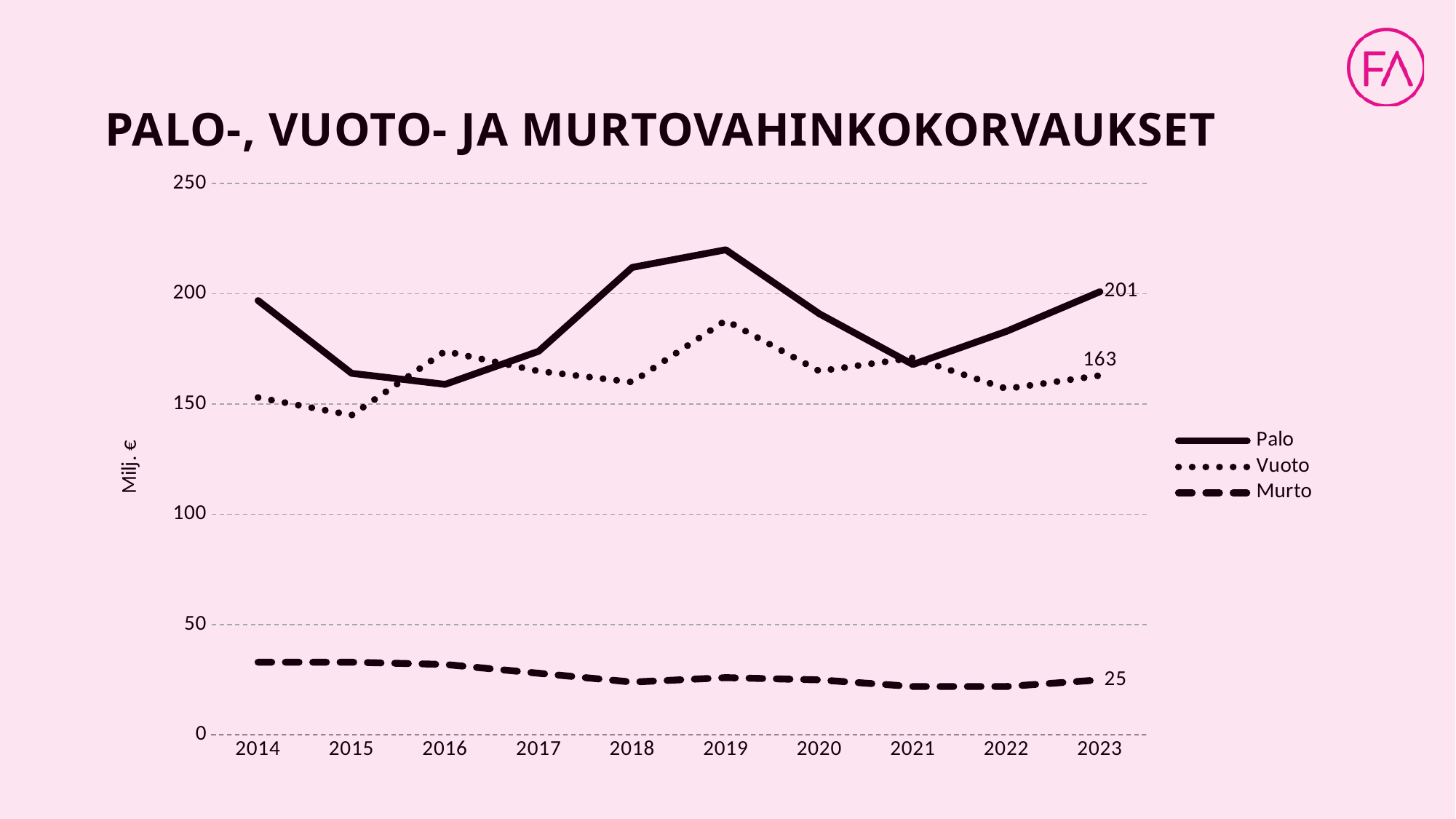
What is the value for Palo in 2023? 201 Is the value for Palo in 2019 greater or less than 200? greater In which year does the Palo line reach its highest point? 2019 What is the difference between the Palo and Vuoto values in 2023? 38 Is the value for Murto in 2014 greater or less than 50? less What kind of chart is shown on the slide? line chart What is the value for Vuoto in 2023? 163 How many years are shown on the x axis? 10 Which series has the larger value in 2023, Palo or Murto? Palo What is the value for Murto in 2023? 25 How many series does the legend list? 3 In which year does the Vuoto line reach its lowest point? 2015